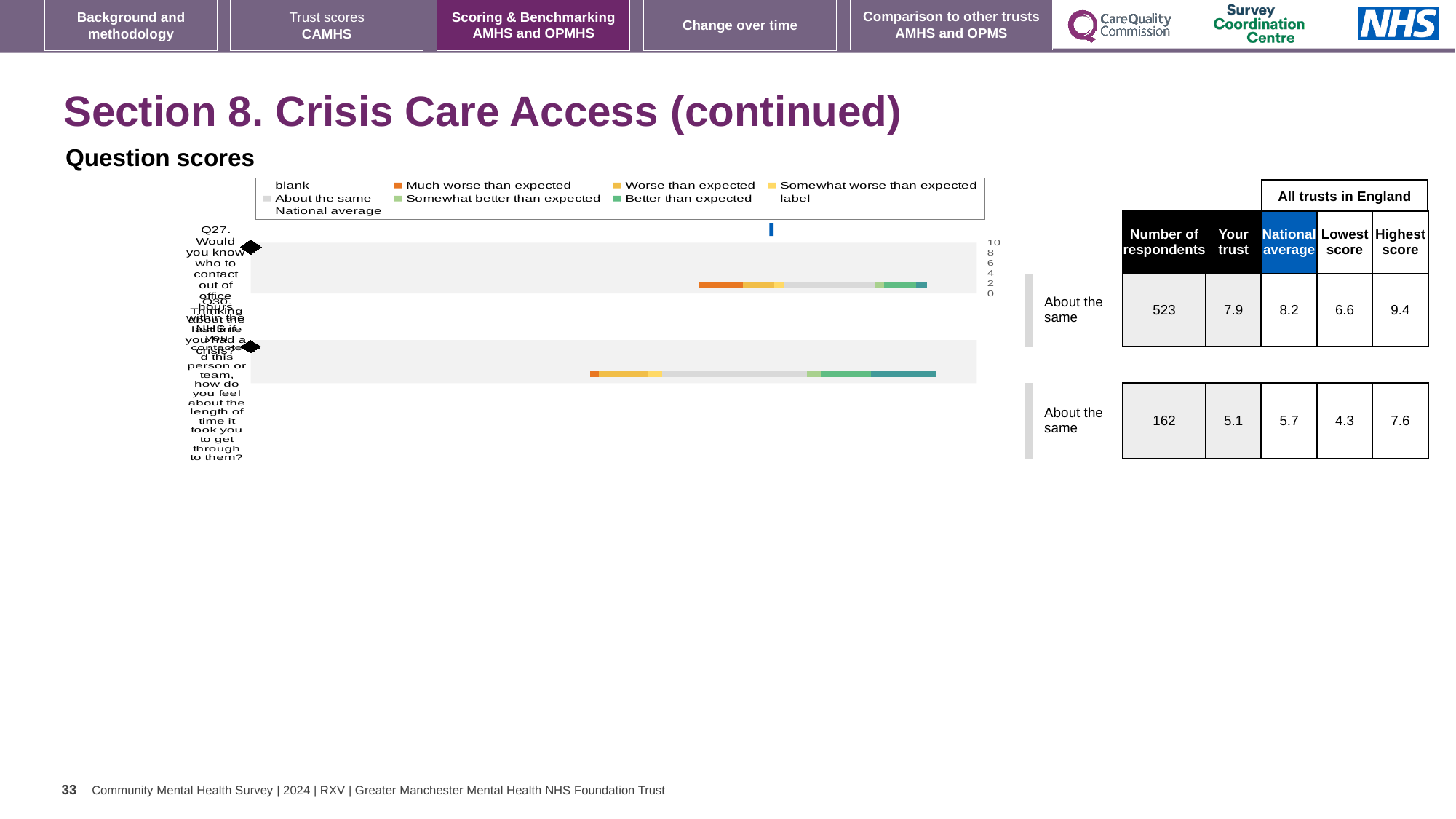
What colour does the legend use for 'Much worse than expected'? Orange In the table beside the chart, how many respondents are shown for Q27? 523 How many questions are plotted as bars in the question scores chart? 2 What kind of chart is used to show the question scores on this slide? bar chart For Q27, which is larger: the 'Your trust' score or the national average? National average What is the 'Your trust' score shown for Q27? 7.9 What is the lowest score among all trusts in England shown for the second question (Q30)? 4.3 Which of the two questions has the higher 'Your trust' score? Q27 What is the national average shown for the second question (Q30)? 5.7 What benchmark category is shown next to the bar for Q27? About the same What is the difference between the highest score and the lowest score shown for the second question (Q30)? 3.3 How many entries does the legend of the question scores chart list? 9